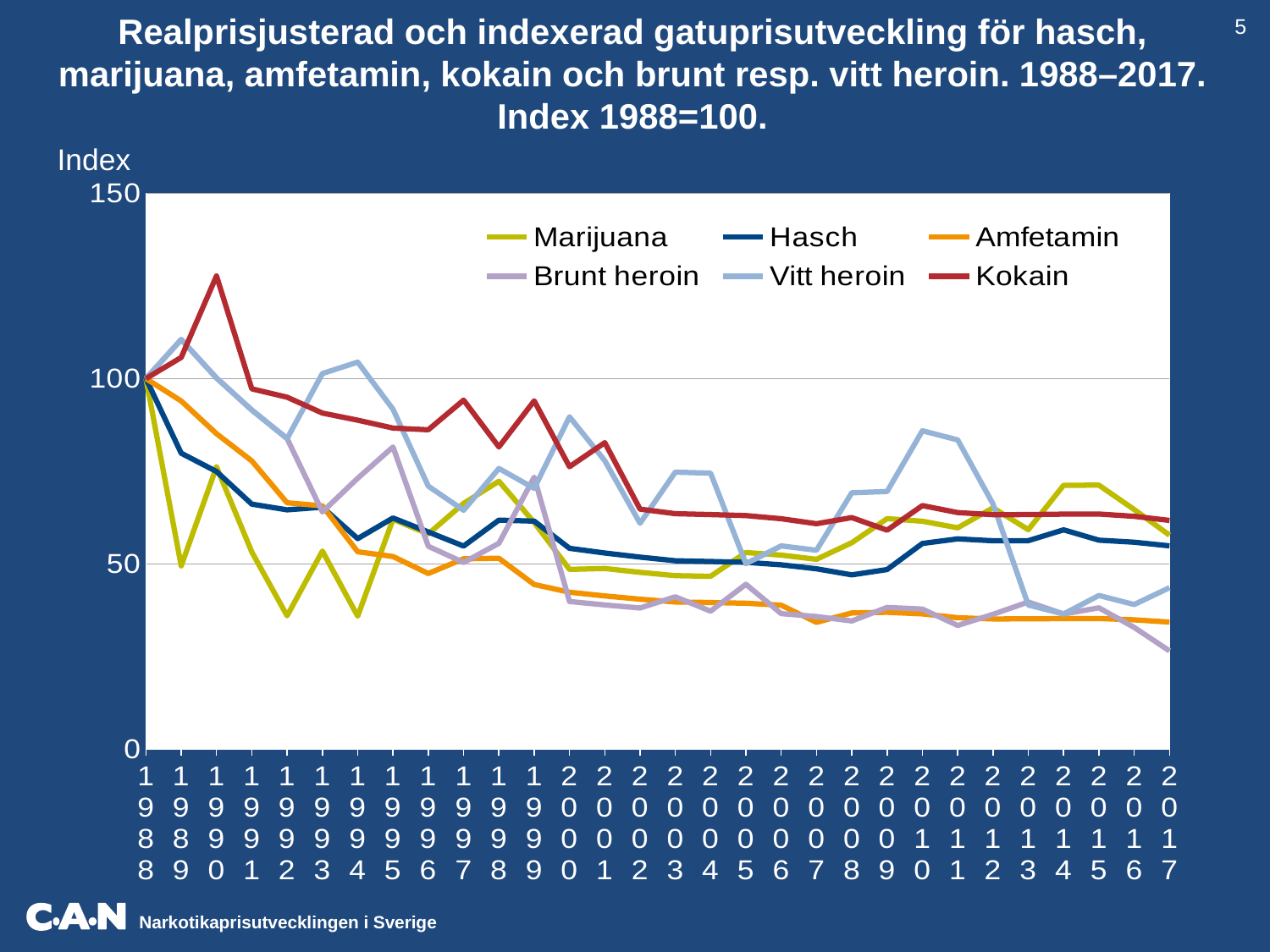
Which series has the lowest value in 2017? Brunt heroin What kind of chart is shown on the slide? line chart Is the value for Vitt heroin in 2010 greater or less than 50? greater Is the value for Kokain in 1990 greater or less than 100? greater What is the index value for Kokain in 1988? 100 Is the value for Brunt heroin in 2017 greater or less than 50? less In 1992, which is larger: the value for Marijuana or the value for Kokain? Kokain How many years are plotted along the x axis? 30 Which series has the highest value in 1990? Kokain What label is shown on the vertical axis? Index How many series does the legend list? 6 Does the Amfetamin series rise or fall overall from 1988 to 2017? fall